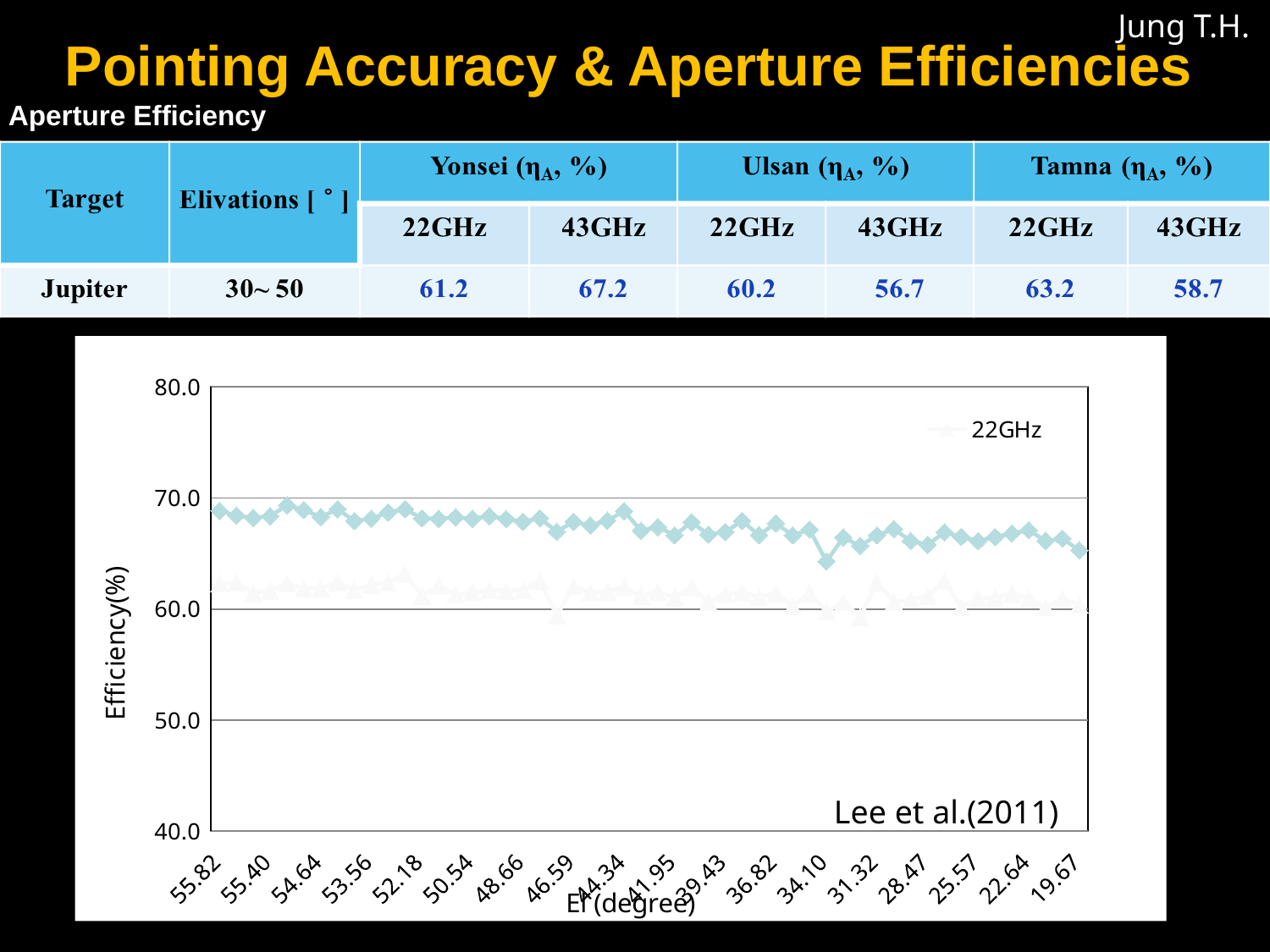
Is the 22GHz value at El 55.82 greater or less than 70? less What is the highest value shown on the y axis of the chart? 80.0 Is the 22GHz value at El 34.10 greater or less than 70? less What is the label of the x axis of the chart? El (degree) Do the 22GHz values generally rise or fall from left to right along the x axis? fall Is the 22GHz value at El 46.59 greater or less than 50? greater What kind of chart is shown on the slide? line chart How many tick labels are shown on the x axis of the chart? 18 What is the label of the y axis of the chart? Efficiency(%) Which of the two is larger: the 22GHz value at El 55.82 or at El 19.67? El 55.82